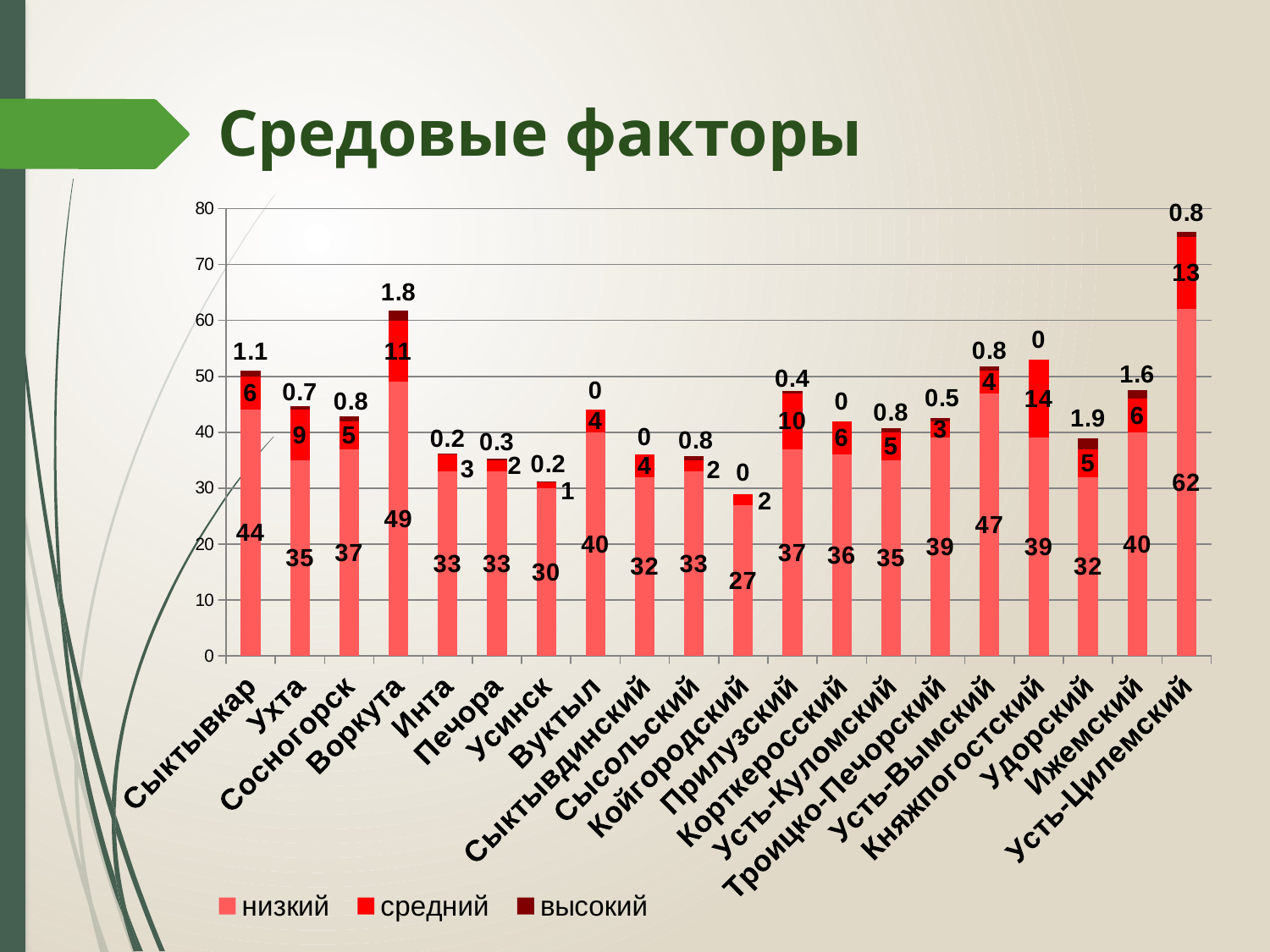
What is the total of the stacked bar for Койгородский? 29 How many series does the legend list? 3 What is the difference between the низкий values for Усть-Цилемский and Воркута? 13 How many categories are shown on the x axis? 20 Which category has the lowest низкий value? Койгородский What is the total of the stacked bar for Усть-Цилемский? 75.8 What is the низкий value for Воркута? 49 Which category has the highest низкий value? Усть-Цилемский What type of chart is shown on the slide? Stacked bar chart What is the средний value for Княжпогостский? 14 What is the высокий value for Удорский? 1.9 Which is larger, the средний value for Прилузский or for Ухта? Прилузский